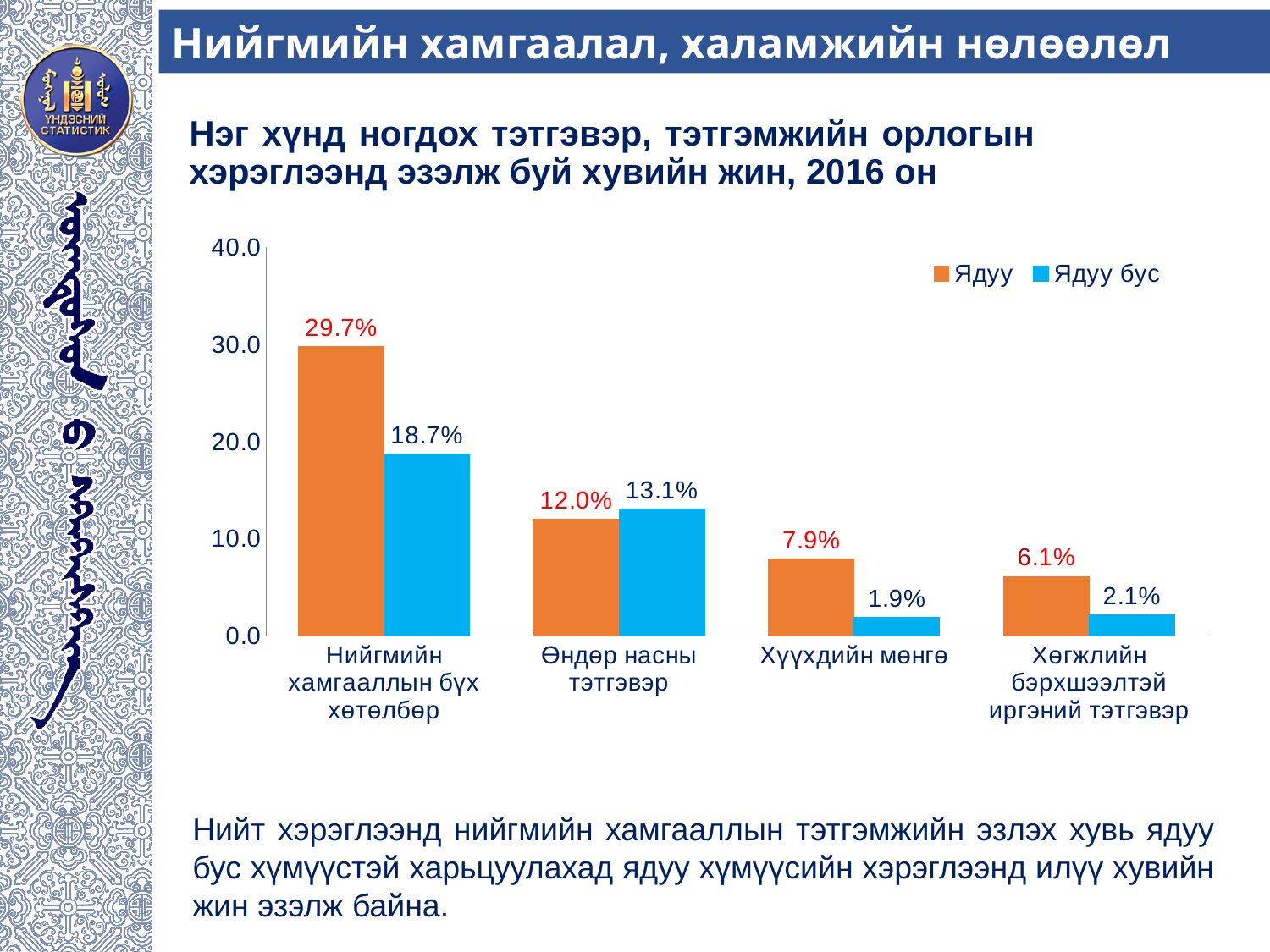
What is the difference between the Ядуу and Ядуу бус values in the Нийгмийн хамгааллын бүх хөтөлбөр category? 11.0% What is the value for Ядуу бус in the Хүүхдийн мөнгө category? 1.9% What is the value for Ядуу бус in the Өндөр насны тэтгэвэр category? 13.1% What is the value for Ядуу in the Хөгжлийн бэрхшээлтэй иргэний тэтгэвэр category? 6.1% In the Өндөр насны тэтгэвэр category, which series has the larger value, Ядуу or Ядуу бус? Ядуу бус Which category has the highest value for the Ядуу series? Нийгмийн хамгааллын бүх хөтөлбөр How many categories are shown on the x axis? 4 Which category has the lowest value for the Ядуу бус series? Хүүхдийн мөнгө Is the Ядуу value for Хүүхдийн мөнгө greater or less than 10.0? less What kind of chart is shown on the slide? bar chart What is the value for Ядуу in the Нийгмийн хамгааллын бүх хөтөлбөр category? 29.7% How many series does the legend list? 2